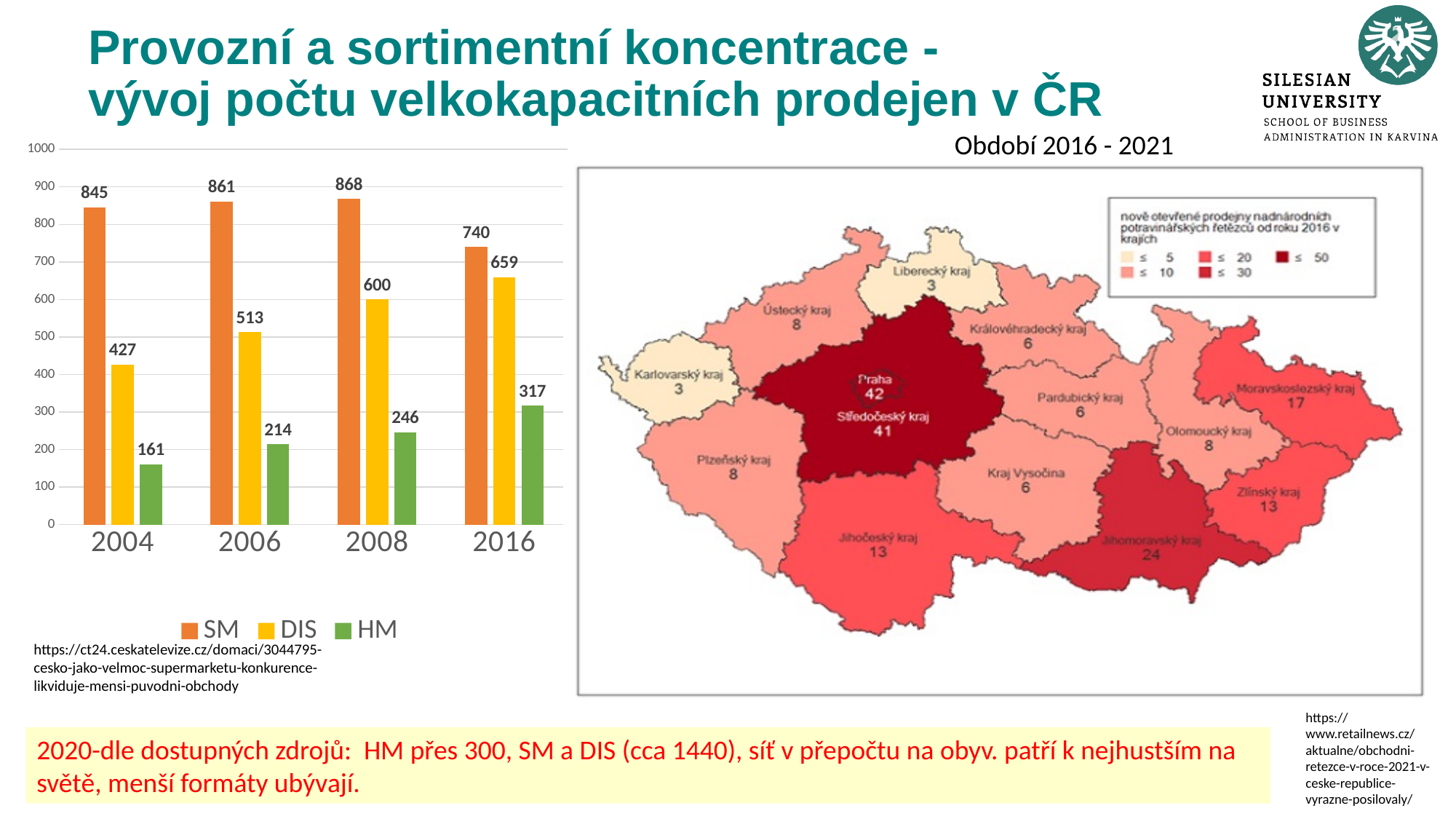
In the bar chart on the left, how many series does the legend list? 3 In the bar chart on the left, do the DIS values rise or fall from 2004 to 2016? rise In the bar chart on the left, in which year is the HM value lowest? 2004 In the bar chart on the left, in which year is the SM value highest? 2008 In the bar chart on the left, what is the value for SM in 2004? 845 In the bar chart on the left, which is larger in 2006: DIS or HM? DIS In the bar chart on the left, how many years are shown on the x axis? 4 In the bar chart on the left, which colour represents the HM series? green In the bar chart on the left, what is the value for HM in 2016? 317 In the bar chart on the left, what is the difference between the SM and DIS values in 2016? 81 In the bar chart on the left, what is the value for DIS in 2008? 600 What kind of chart is shown on the left of the slide? bar chart